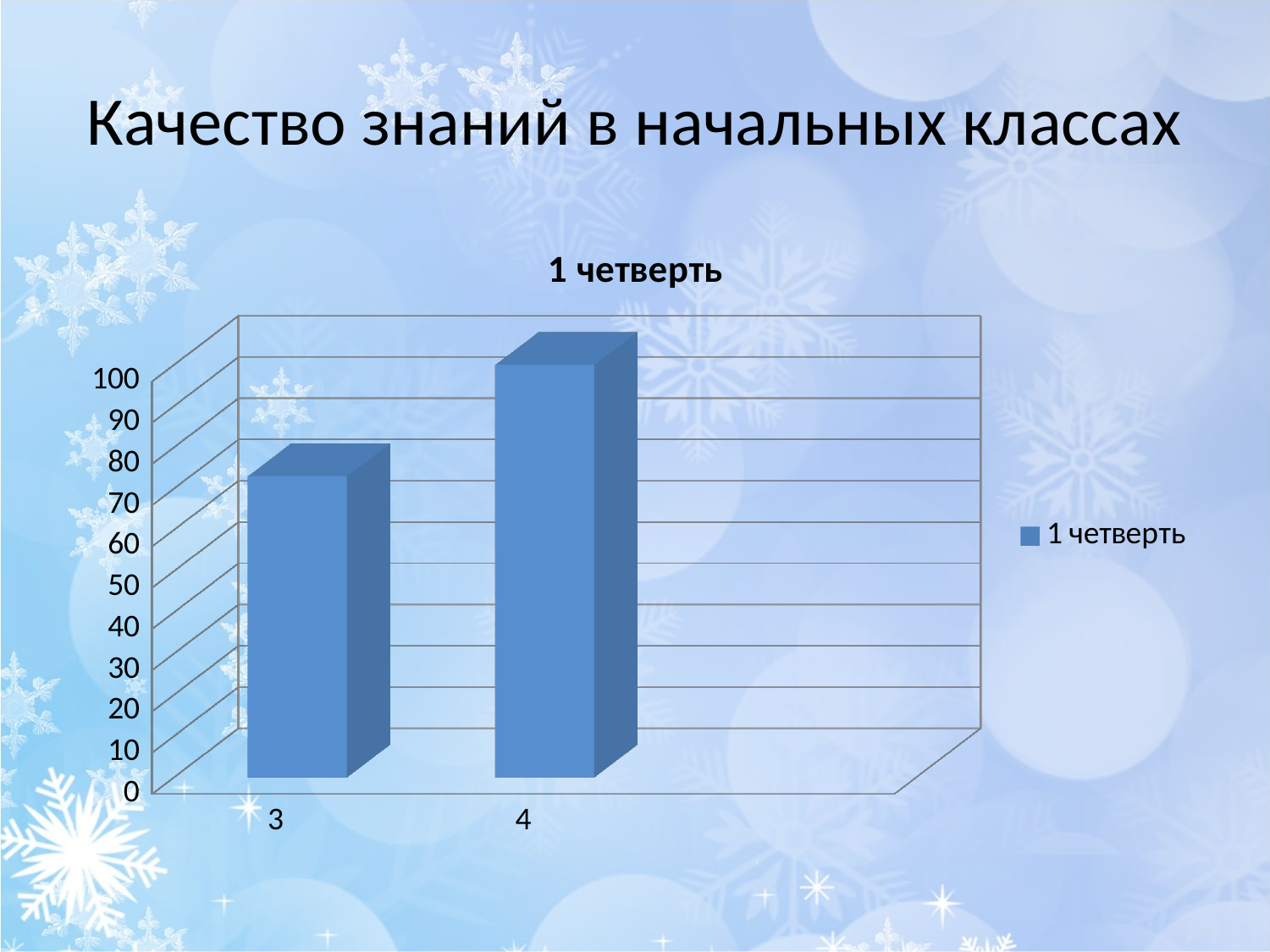
How many categories are plotted on the x axis? 2 What is the title of the chart? 1 четверть What kind of chart is shown on the slide? bar chart What is the name of the series shown in the legend? 1 четверть Which category has the highest bar? 4 Which bar is taller, the one for 3 or the one for 4? 4 Do the values rise or fall from category 3 to category 4? rise Is the value for category 4 greater or less than 80? greater Which category has the lowest bar? 3 Is the value for category 3 greater or less than 90? less How many series does the legend list? 1 Is the value for category 3 greater or less than 50? greater